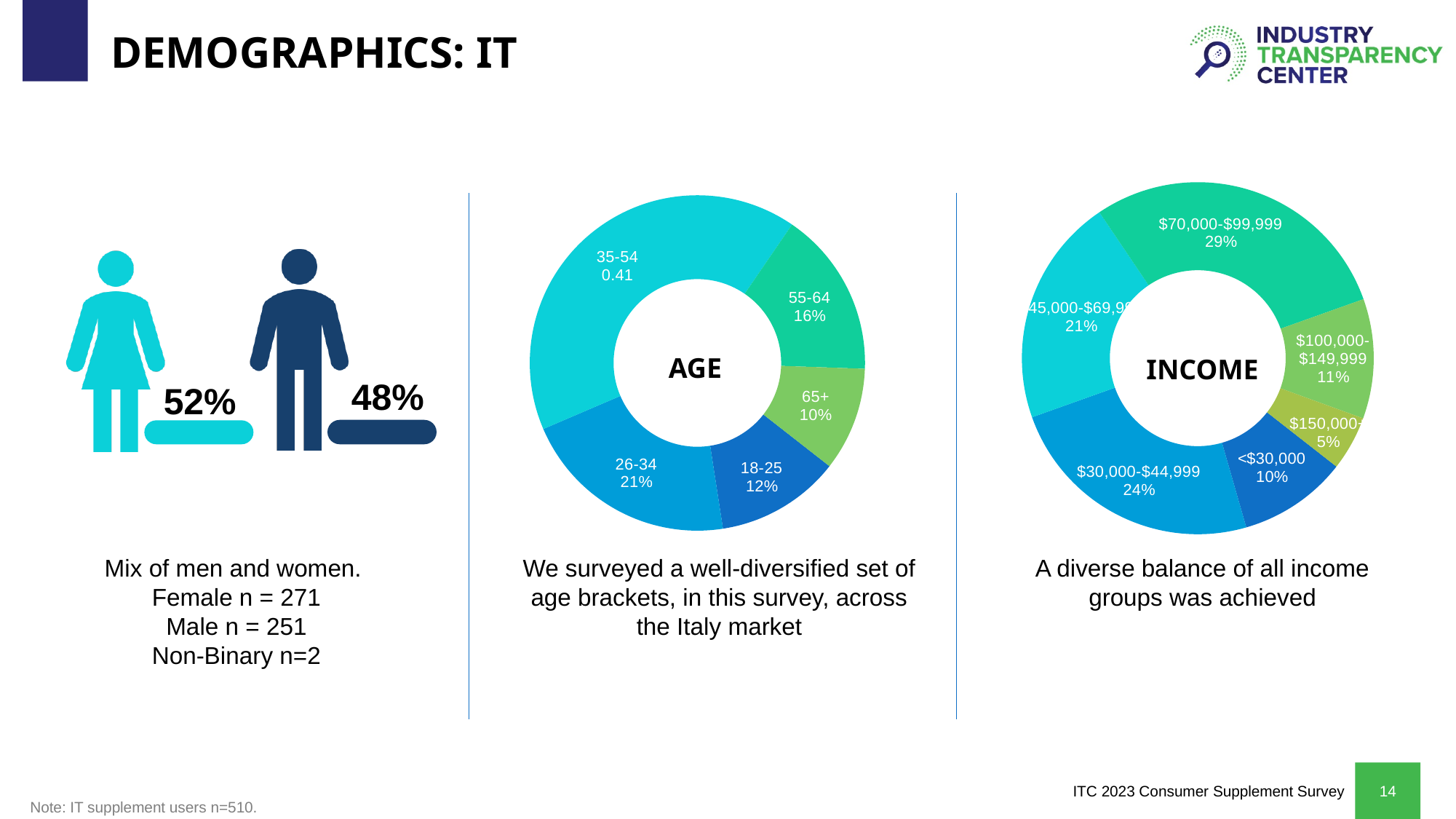
What kind of chart is the AGE chart? doughnut chart How many income groups are shown in the INCOME chart? 6 In the AGE chart, which age bracket has the largest slice? 35-54 In the AGE chart, which age bracket has the smallest slice? 65+ In the INCOME chart, which income group has the smallest share? $150,000+ In the AGE chart, what value is shown for the 55-64 bracket? 16% How many age brackets are shown in the AGE chart? 5 In the INCOME chart, which is larger: the share for $30,000-$44,999 or the share for $100,000-$149,999? $30,000-$44,999 In the INCOME chart, which income group has the largest share? $70,000-$99,999 In the AGE chart, what value is printed for the 35-54 bracket? 0.41 In the AGE chart, what is the difference between the 26-34 share and the 18-25 share? 9 percentage points In the INCOME chart, what share is shown for $70,000-$99,999? 29%